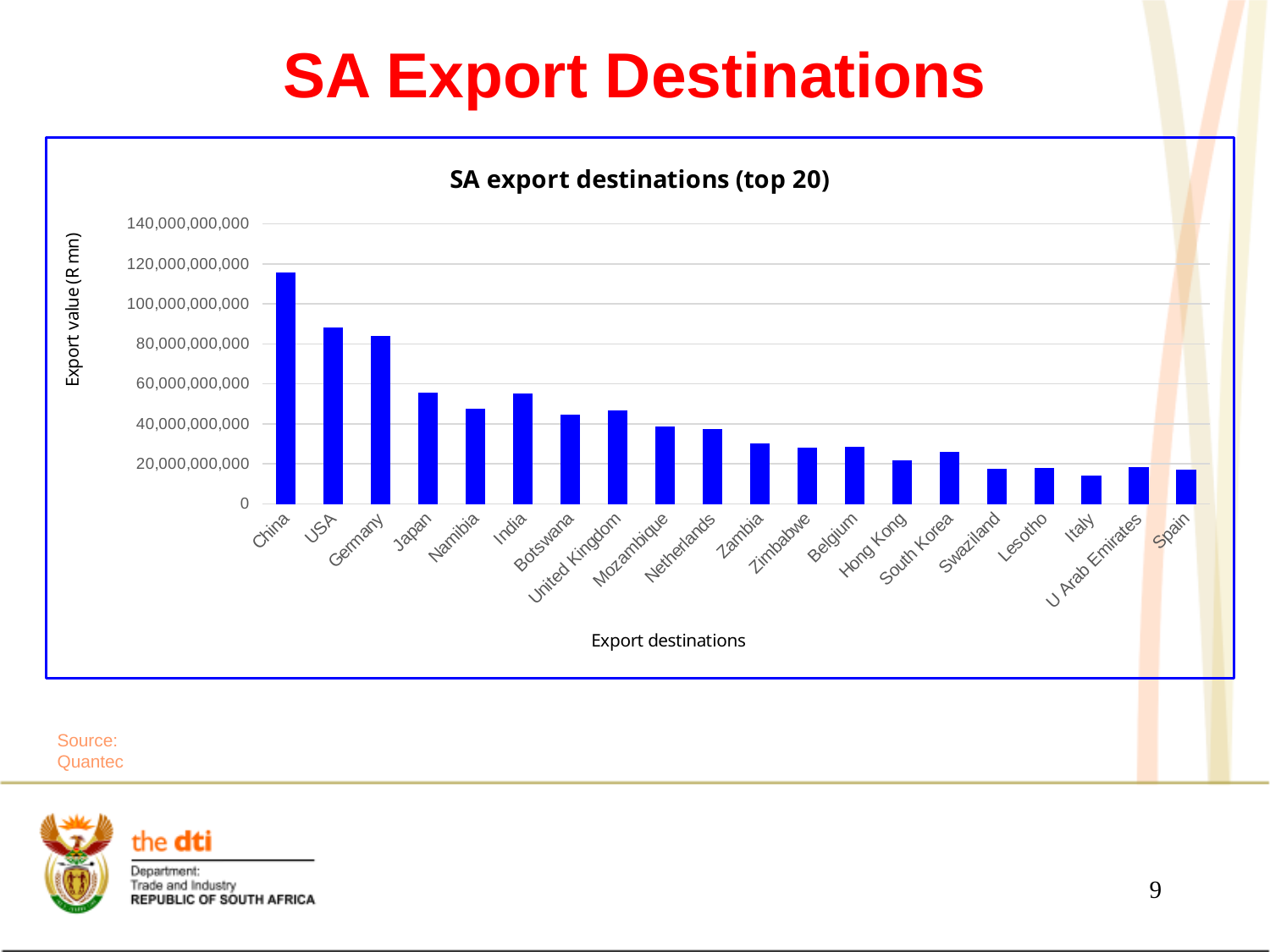
Is the export value for Japan greater or less than 60,000,000,000? less Is the export value for China greater or less than 100,000,000,000? greater What kind of chart is shown on the slide? Bar chart Which export destination has the highest export value? China Which has a larger export value, Belgium or Hong Kong? Belgium What is the title of the chart? SA export destinations (top 20) How many export destinations are plotted in the chart? 20 Is the export value for Zambia greater or less than 40,000,000,000? less Do the export values generally rise or fall moving from left to right across the destinations? Fall Which has a larger export value, Japan or Namibia? Japan